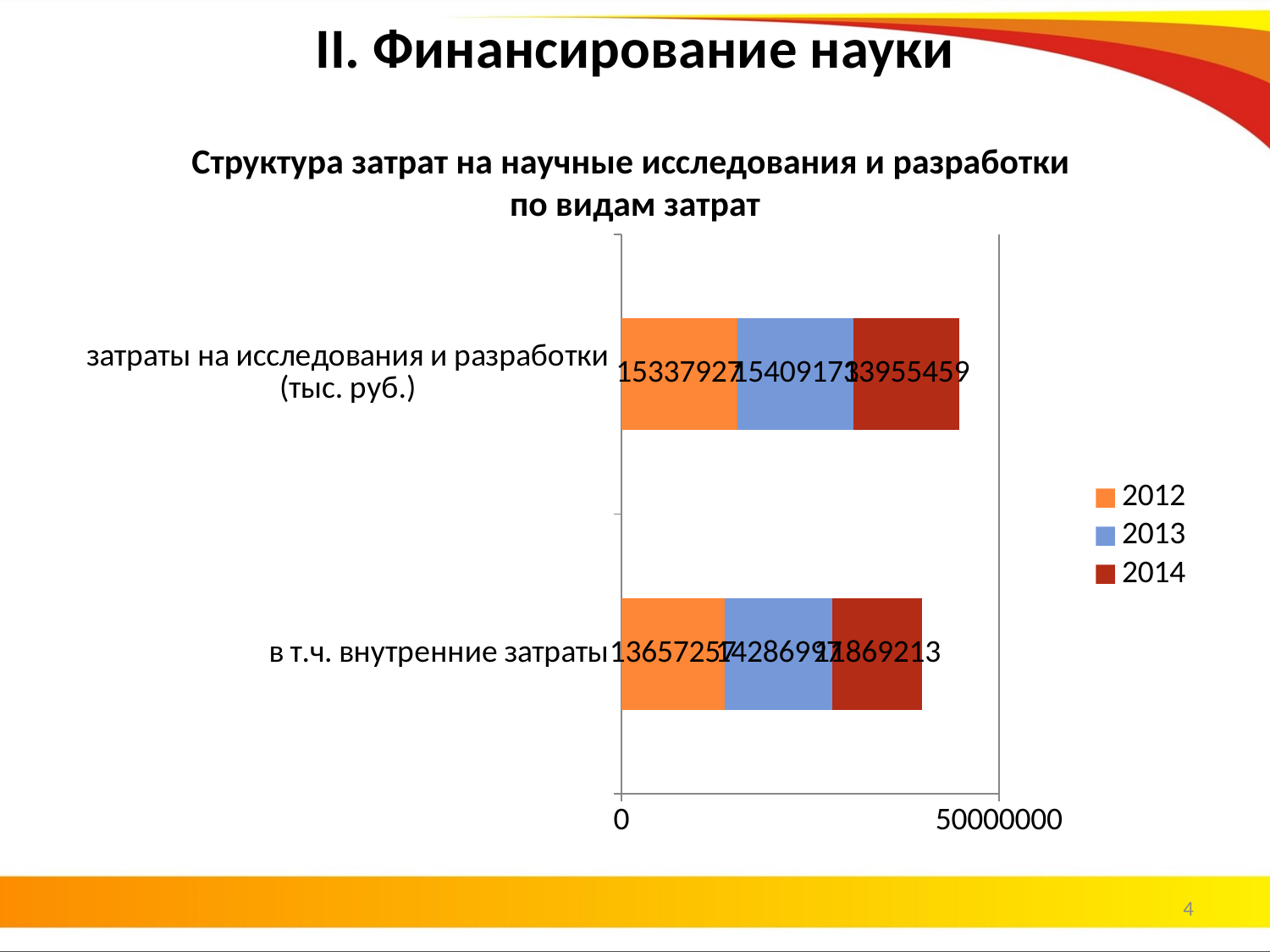
Which category has the longer total stacked bar? затраты на исследования и разработки (тыс. руб.) What is the 2012 value for "в т.ч. внутренние затраты"? 13657257 Which colour represents the 2014 series? dark red Which is larger: the 2012 value for "затраты на исследования и разработки (тыс. руб.)" or the 2012 value for "в т.ч. внутренние затраты"? затраты на исследования и разработки (тыс. руб.) What is the 2012 value for "затраты на исследования и разработки (тыс. руб.)"? 15337927 Which years are listed in the legend? 2012, 2013, 2014 How many series does the legend list? 3 In the bar for "в т.ч. внутренние затраты", which year has the smallest segment? 2014 How many categories are plotted on the chart? 2 What kind of chart is shown on the slide? stacked bar chart What is the title of the chart? Структура затрат на научные исследования и разработки по видам затрат Is the total stacked bar for "затраты на исследования и разработки (тыс. руб.)" greater or less than 50000000? less